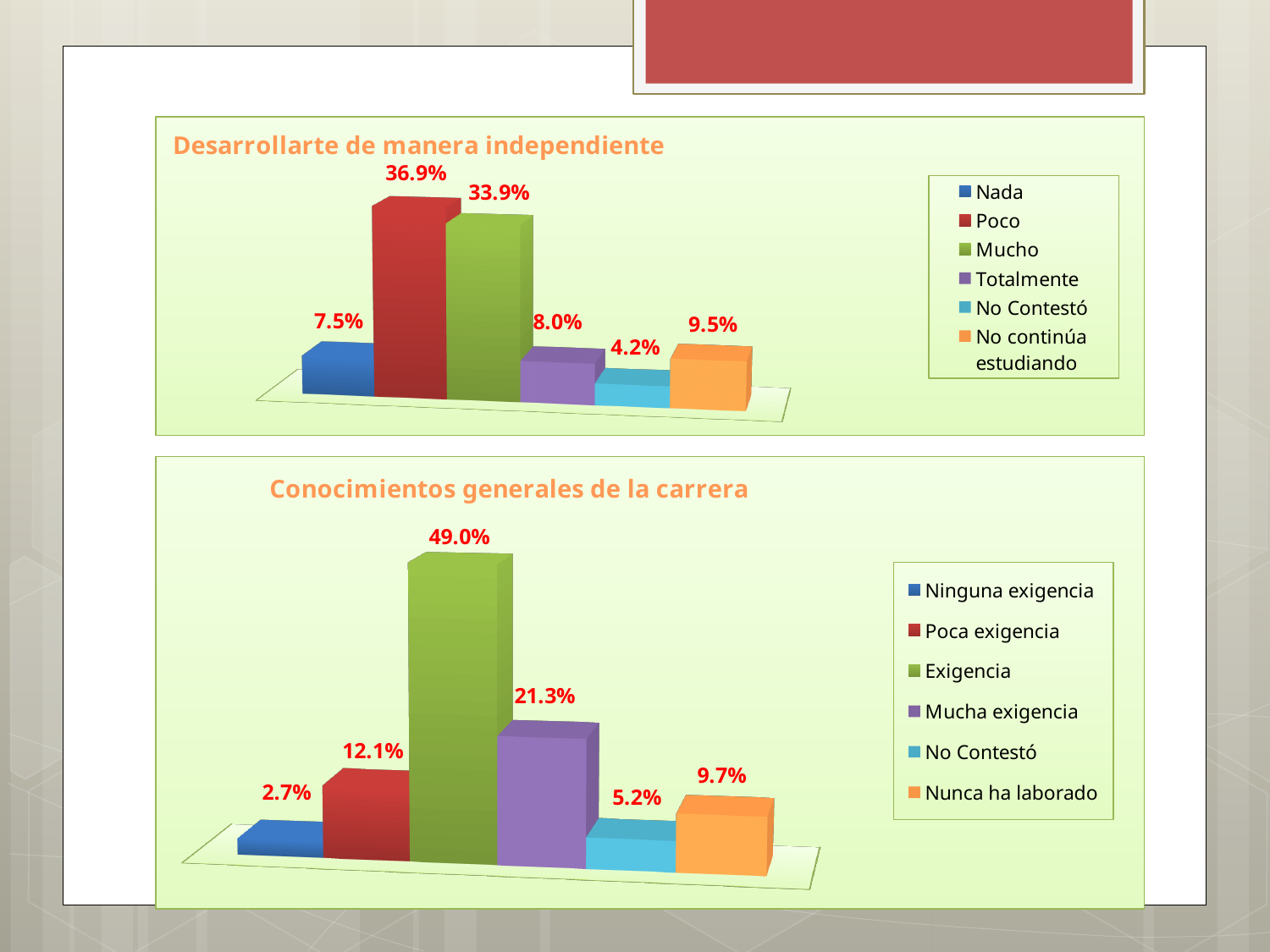
In the chart titled "Desarrollarte de manera independiente", which category has the lowest value? No Contestó In the chart titled "Desarrollarte de manera independiente", how many entries does the legend list? 6 In the chart titled "Conocimientos generales de la carrera", what is the value for Exigencia? 49.0% In the chart titled "Desarrollarte de manera independiente", what is the value for No continúa estudiando? 9.5% In the chart titled "Desarrollarte de manera independiente", what is the value for Poco? 36.9% In the chart titled "Conocimientos generales de la carrera", what is the difference between the values for Exigencia and Mucha exigencia? 27.7% In the chart titled "Conocimientos generales de la carrera", which is larger, Poca exigencia or Nunca ha laborado? Poca exigencia In the chart titled "Conocimientos generales de la carrera", which category has the lowest value? Ninguna exigencia In the chart titled "Desarrollarte de manera independiente", what is the difference between the values for Poco and Mucho? 3.0% What kind of chart is the bottom chart on the slide? Bar chart In the chart titled "Conocimientos generales de la carrera", what is the value for Mucha exigencia? 21.3% In the chart titled "Conocimientos generales de la carrera", which category has the highest value? Exigencia